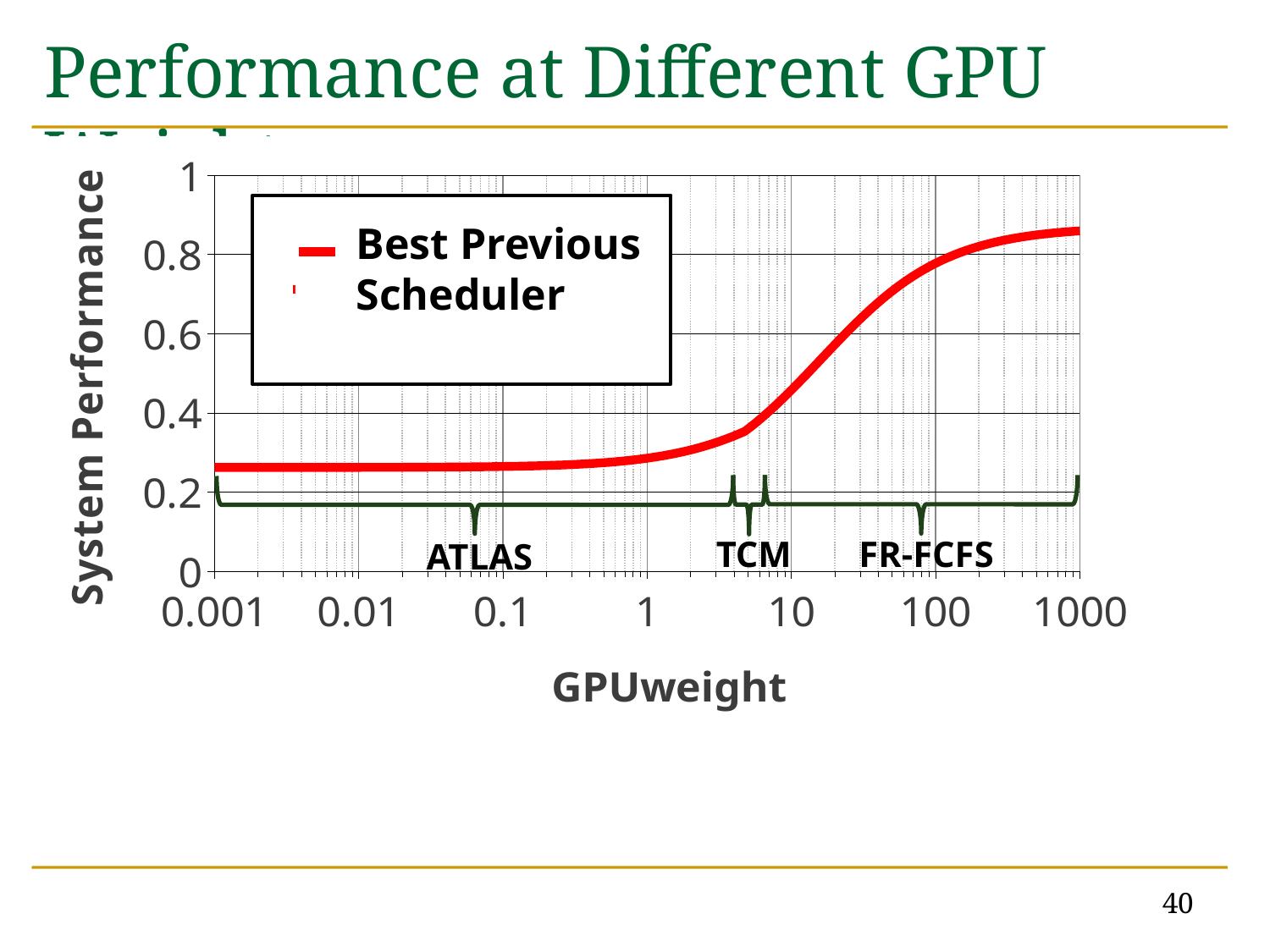
What is the name of the series shown in the legend? Best Previous Scheduler Which has the higher System Performance: GPUweight 0.01 or GPUweight 100? GPUweight 100 Is the System Performance value at GPUweight 1 greater or less than 0.4? less Is the System Performance value at GPUweight 1000 greater or less than 0.8? greater What is the label of the x axis? GPUweight What kind of chart is shown on the slide? line chart How many series does the chart's legend list? 1 Is the System Performance value at GPUweight 10 greater or less than 0.4? greater How many labeled tick values are shown on the x axis? 7 Does the System Performance value rise or fall as GPUweight increases along the x axis? rise